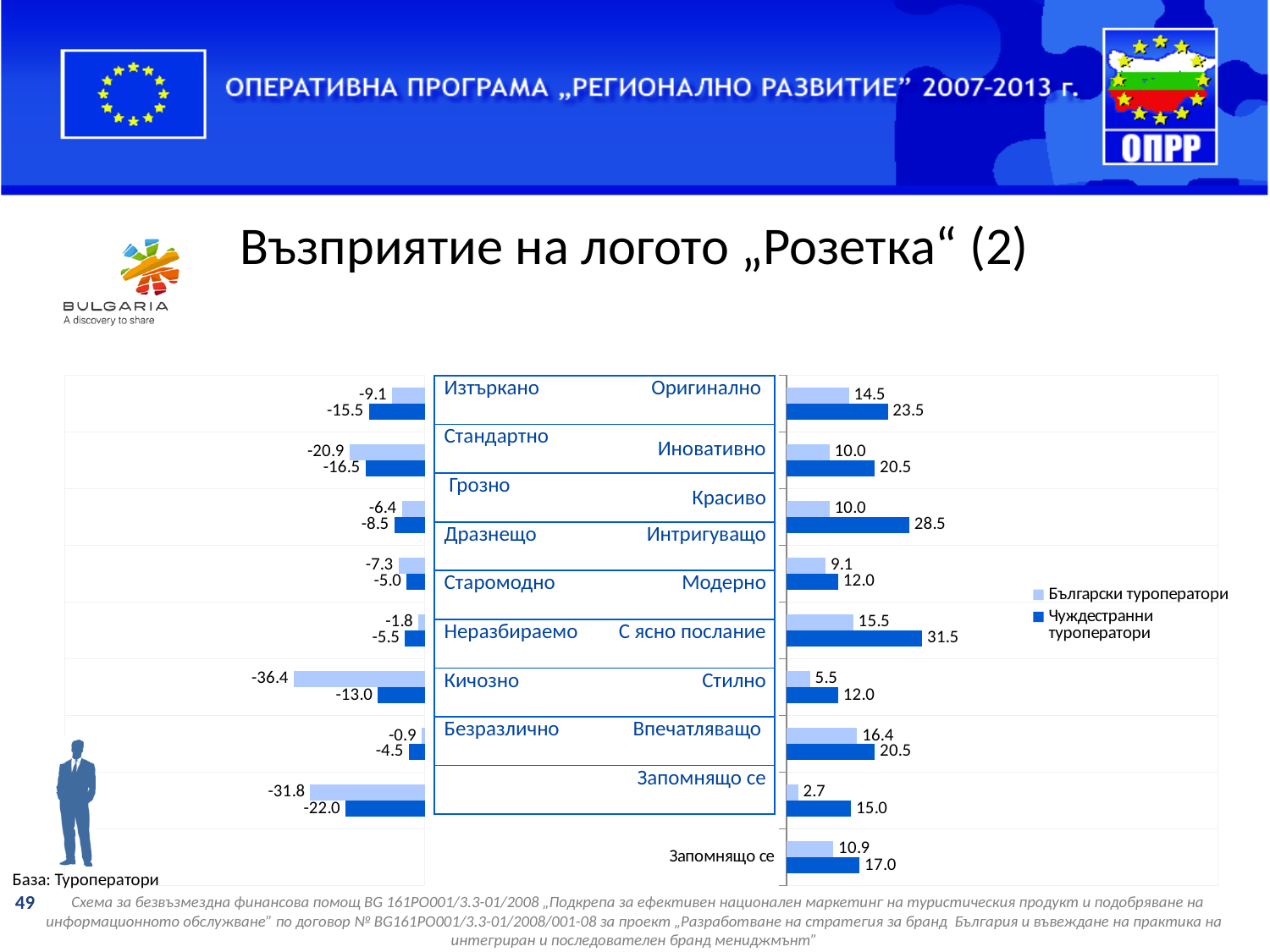
What kind of chart is used on this slide? bar chart In the right-hand chart, what is the highest value shown for Чуждестранни туроператори? 31.5 In the right-hand chart, which series has the larger value in the top row: Български туроператори or Чуждестранни туроператори? Чуждестранни туроператори In the right-hand chart, what is the lowest value shown for Български туроператори? 2.7 In the right-hand chart, what is the difference between the Чуждестранни туроператори and Български туроператори values in the bottom row labelled Запомнящо се? 6.1 Which series is shown in light blue according to the legend? Български туроператори In the left-hand chart, what is the value for Чуждестранни туроператори in the top row? -15.5 In the left-hand chart, what is the lowest (most negative) value shown for Български туроператори? -36.4 How many series does the legend list? 2 In the right-hand chart, what is the value for Чуждестранни туроператори in the row labelled Запомнящо се at the bottom? 17.0 How many rows of bars are plotted in the right-hand chart? 9 In the right-hand chart, what is the value for Български туроператори in the row labelled Запомнящо се at the bottom? 10.9